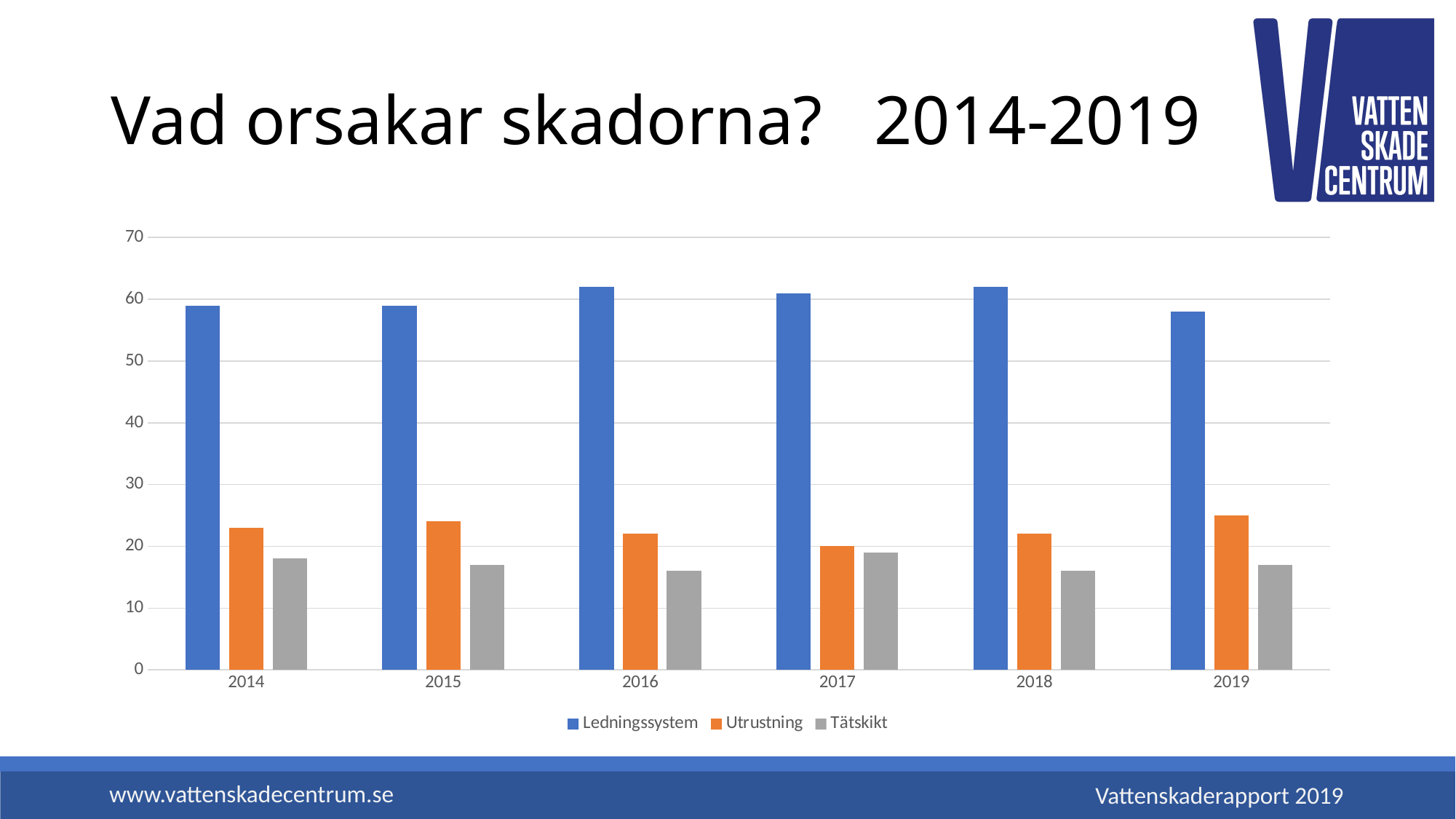
How many series does the legend list? 3 What colour are the Utrustning bars? Orange How many years are shown on the x axis? 6 Is the value for Utrustning in 2019 greater or less than 20? greater Is the value for Tätskikt in 2018 greater or less than 20? less In 2019, which is larger: Ledningssystem or Utrustning? Ledningssystem Which series has the lowest value in 2014? Tätskikt Which series has the highest value in every year shown? Ledningssystem What kind of chart is shown on the slide? Bar chart In 2014, which is larger: Utrustning or Tätskikt? Utrustning Is the value for Ledningssystem in 2016 greater or less than 50? greater